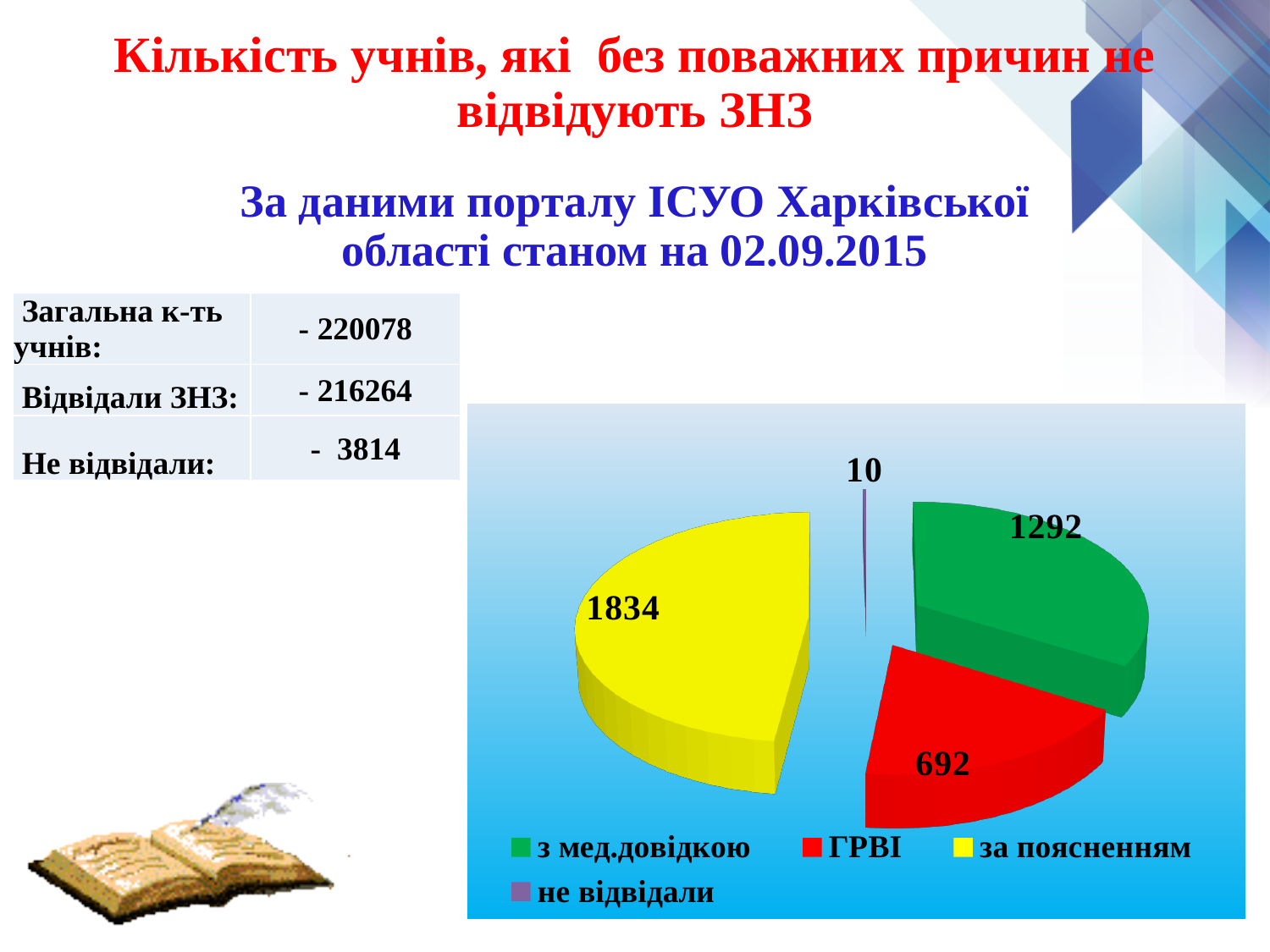
Which category has the largest slice in the pie chart? за поясненням What is the value for the 'ГРВІ' slice of the pie chart? 692 What is the value for the 'за поясненням' slice of the pie chart? 1834 What is the value for the 'з мед.довідкою' slice of the pie chart? 1292 What is the difference between the 'з мед.довідкою' and 'ГРВІ' values in the pie chart? 600 What kind of chart is shown on the slide? pie chart How many categories does the pie chart legend list? 4 What is the difference between the 'за поясненням' and 'з мед.довідкою' values in the pie chart? 542 Which category has the smallest slice in the pie chart? не відвідали What colour is the 'ГРВІ' slice in the pie chart? red What is the value for the 'не відвідали' slice of the pie chart? 10 Which is larger in the pie chart, 'ГРВІ' or 'з мед.довідкою'? з мед.довідкою